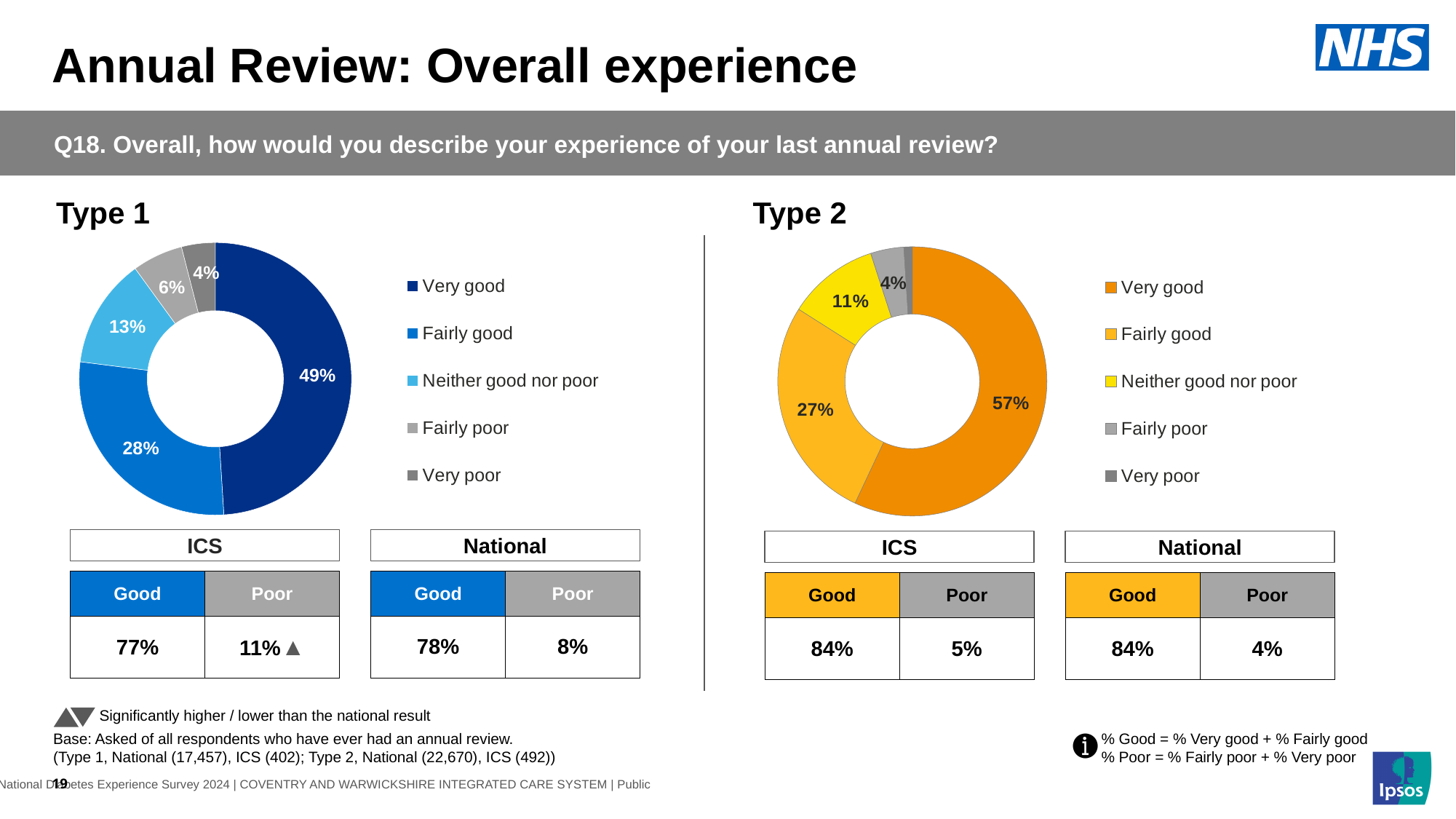
In the Type 1 chart, what percentage of respondents said 'Fairly poor'? 6% In the Type 2 chart, what is the difference between the 'Very good' and 'Neither good nor poor' percentages? 46 percentage points In the Type 1 chart, what percentage of respondents said their experience was 'Very good'? 49% What colour represents 'Neither good nor poor' in the Type 2 chart? Yellow Which is larger: the 'Very good' share in the Type 1 chart or the 'Very good' share in the Type 2 chart? Type 2 In the Type 2 chart, which category has the largest share? Very good In the Type 1 chart, what percentage of respondents said 'Neither good nor poor'? 13% What kind of chart is used to show the Type 2 results? Pie (doughnut) chart How many categories does the legend of the Type 1 chart list? 5 In the Type 1 chart, what is the difference between the 'Very good' and 'Fairly good' percentages? 21 percentage points In the Type 2 chart, what percentage of respondents said their experience was 'Fairly good'? 27% In the Type 1 chart, which category has the smallest share? Very poor